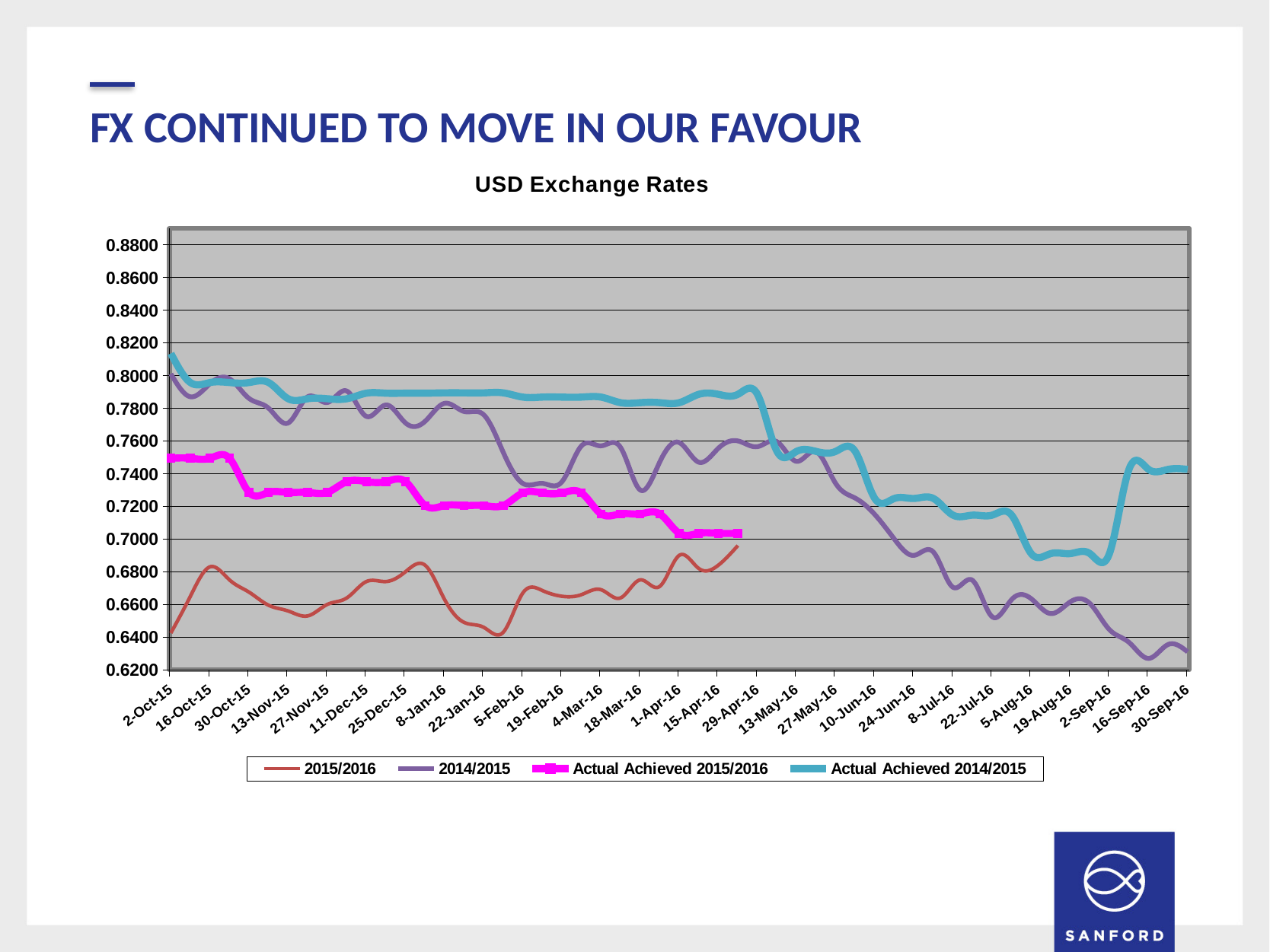
How many date labels are shown on the x axis? 27 Is the value of the Actual Achieved 2014/2015 series at 2-Oct-15 greater or less than 0.8000? greater At 2-Oct-15, which series has the higher value, 2015/2016 or 2014/2015? 2014/2015 At 30-Sep-16, which series has the lower value, 2014/2015 or Actual Achieved 2014/2015? 2014/2015 Is the value of the 2014/2015 series at 30-Sep-16 greater or less than 0.6400? less Which series is drawn with the thick pink line? Actual Achieved 2015/2016 What is the title of the chart? USD Exchange Rates Is the value of the 2015/2016 series at 2-Oct-15 greater or less than 0.6600? less Does the 2014/2015 series generally rise or fall from 2-Oct-15 to 30-Sep-16? Fall What type of chart is shown on the slide? Line chart How many series does the legend list? 4